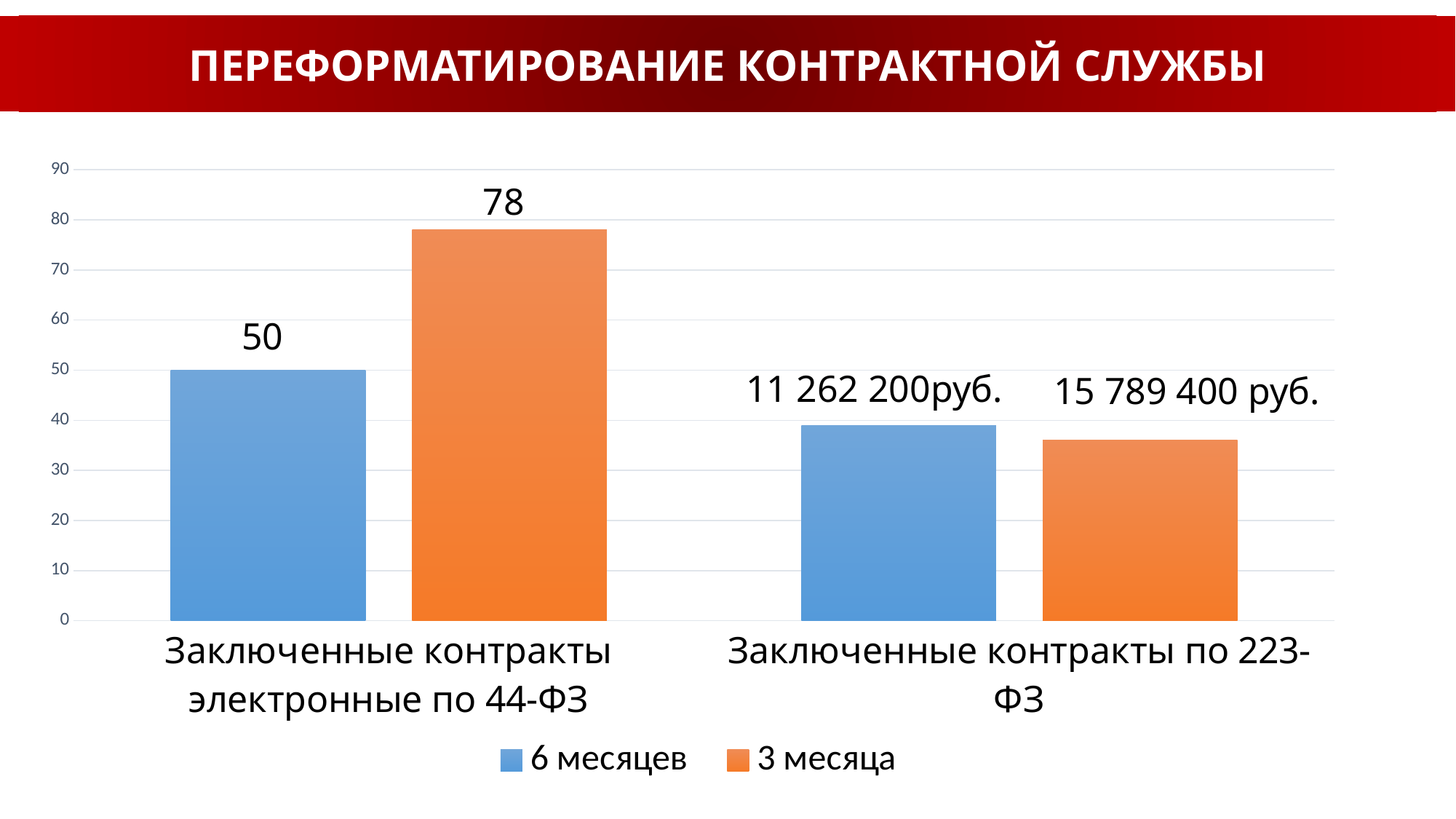
In the category «Заключенные контракты электронные по 44-ФЗ», what is the difference between the «3 месяца» and «6 месяцев» values? 28 What data label is shown for «6 месяцев» in the category «Заключенные контракты по 223-ФЗ»? 11 262 200руб. What data label is shown for «3 месяца» in the category «Заключенные контракты по 223-ФЗ»? 15 789 400 руб. What kind of chart is shown on the slide? bar chart What is the value for «3 месяца» in the category «Заключенные контракты электронные по 44-ФЗ»? 78 In the category «Заключенные контракты электронные по 44-ФЗ», which series has the larger value, «6 месяцев» or «3 месяца»? 3 месяца What is the value for «6 месяцев» in the category «Заключенные контракты электронные по 44-ФЗ»? 50 Is the value for «3 месяца» in the category «Заключенные контракты электронные по 44-ФЗ» greater or less than 70? greater How many categories are shown on the x axis of the chart? 2 What is the title of the slide? ПЕРЕФОРМАТИРОВАНИЕ КОНТРАКТНОЙ СЛУЖБЫ Which series is shown in orange according to the legend? 3 месяца How many series does the legend list? 2